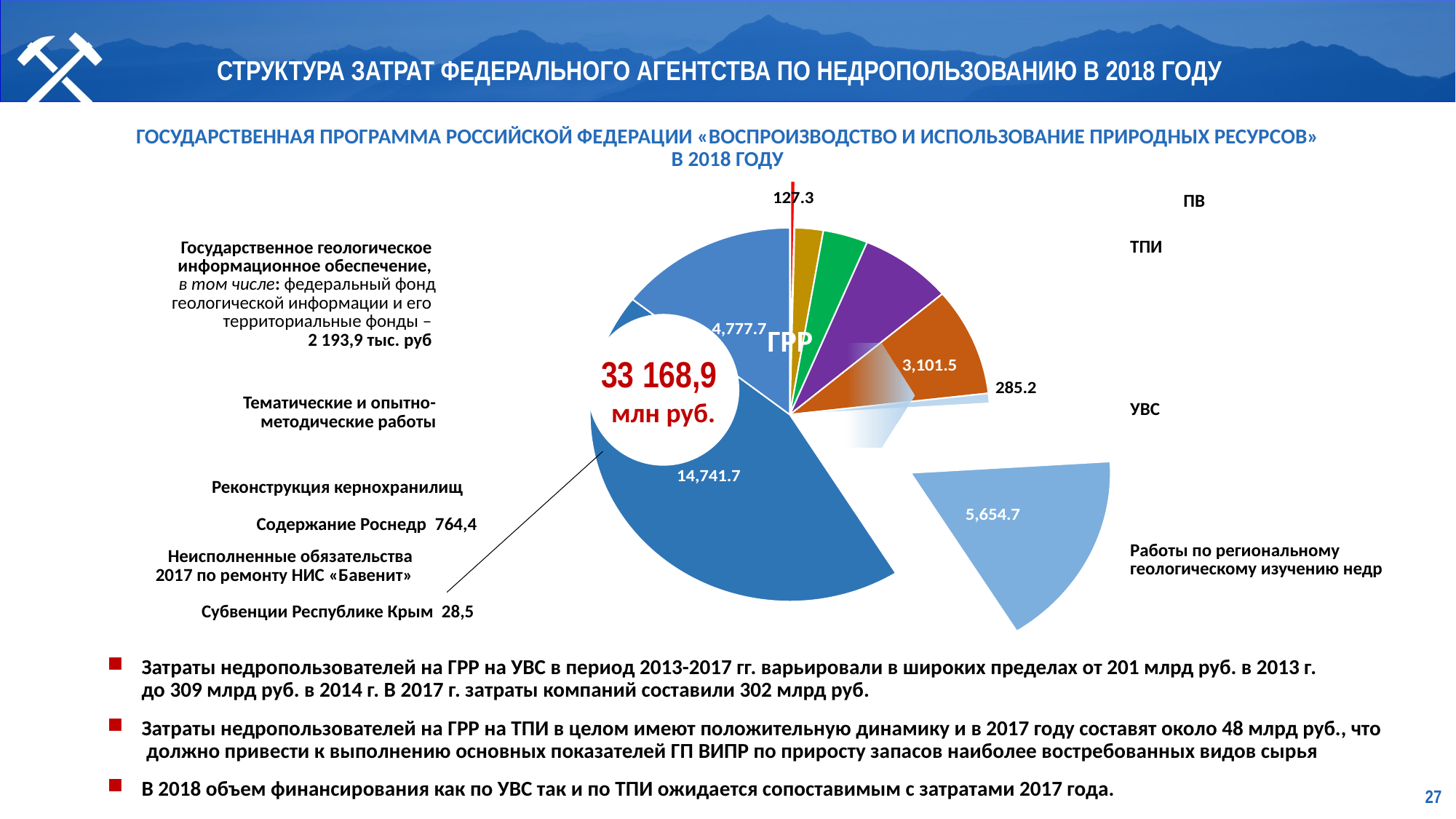
What share of the total 33 168,9 does the slice labelled 14,741.7 represent? 44.4% What total value is printed in the centre of the pie chart? 33 168,9 млн руб. What kind of chart is shown on the slide? pie chart What value is given for «Содержание Роснедр»? 764,4 What is the difference between the slice labelled 14,741.7 and the slice labelled 5,654.7? 9,087.0 Which is larger, the slice labelled 4,777.7 or the slice labelled 3,101.5? 4,777.7 What is the difference between the slice labelled 3,101.5 and the slice labelled 285.2? 2,816.3 What value is printed on the exploded light-blue slice labelled «Работы по региональному геологическому изучению недр»? 5,654.7 What is the largest value printed on a slice of the pie chart? 14,741.7 What value is given for «Субвенции Республике Крым»? 28,5 What is the smallest value printed on a slice of the pie chart? 127.3 What colour is the slice labelled 3,101.5? orange